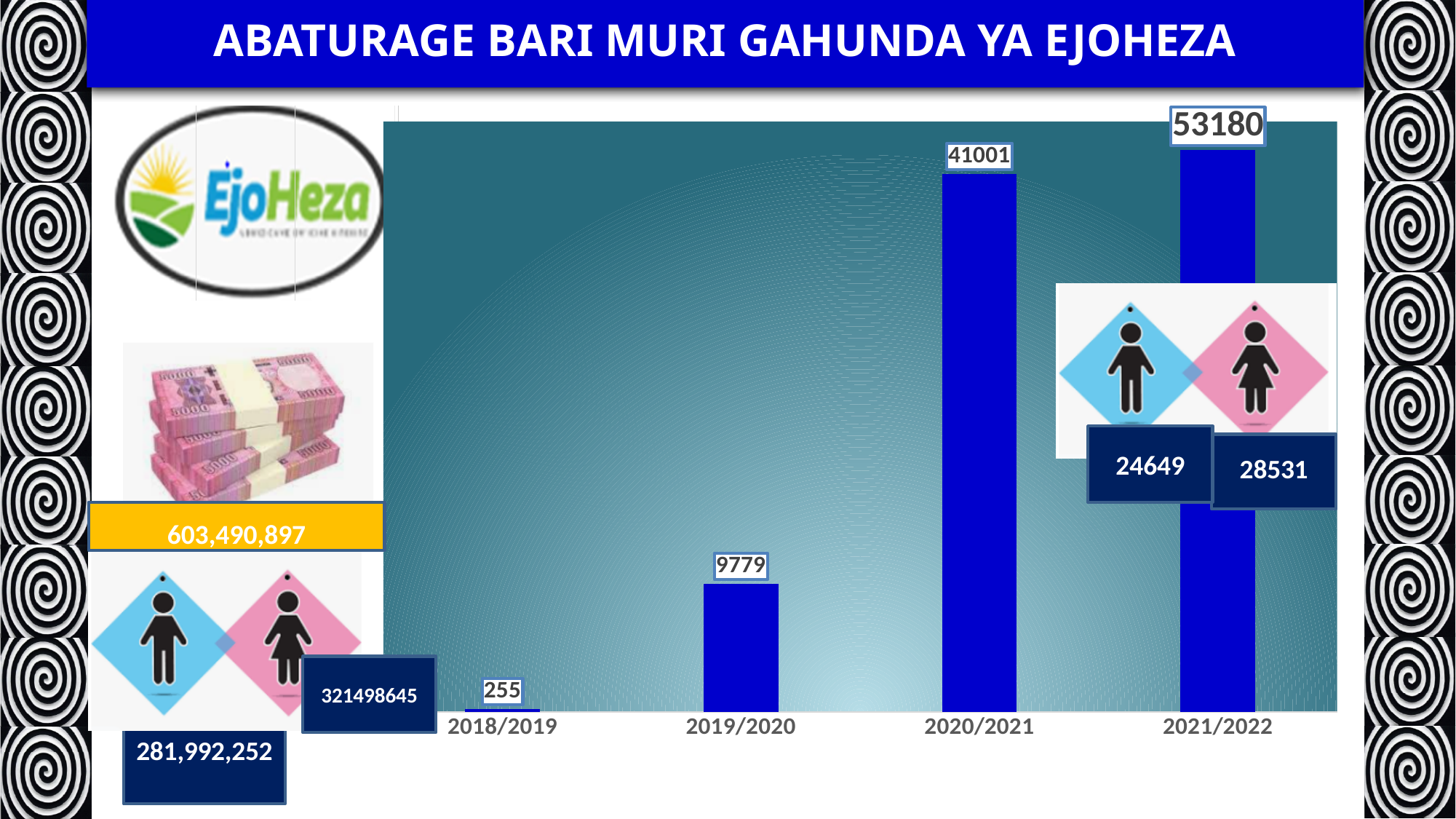
What is the difference between the values for 2021/2022 and 2020/2021? 12179 What is the difference between the values for 2019/2020 and 2018/2019? 9524 Which year has the lowest value? 2018/2019 Which is larger, the value for 2019/2020 or the value for 2020/2021? 2020/2021 What is the value for 2020/2021? 41001 How many years are shown on the x axis of the chart? 4 Do the values rise or fall from 2018/2019 to 2021/2022? rise What is the value for 2018/2019? 255 What is the value for 2019/2020? 9779 What is the value for 2021/2022? 53180 Which year has the highest value? 2021/2022 What kind of chart is shown on the slide? bar chart